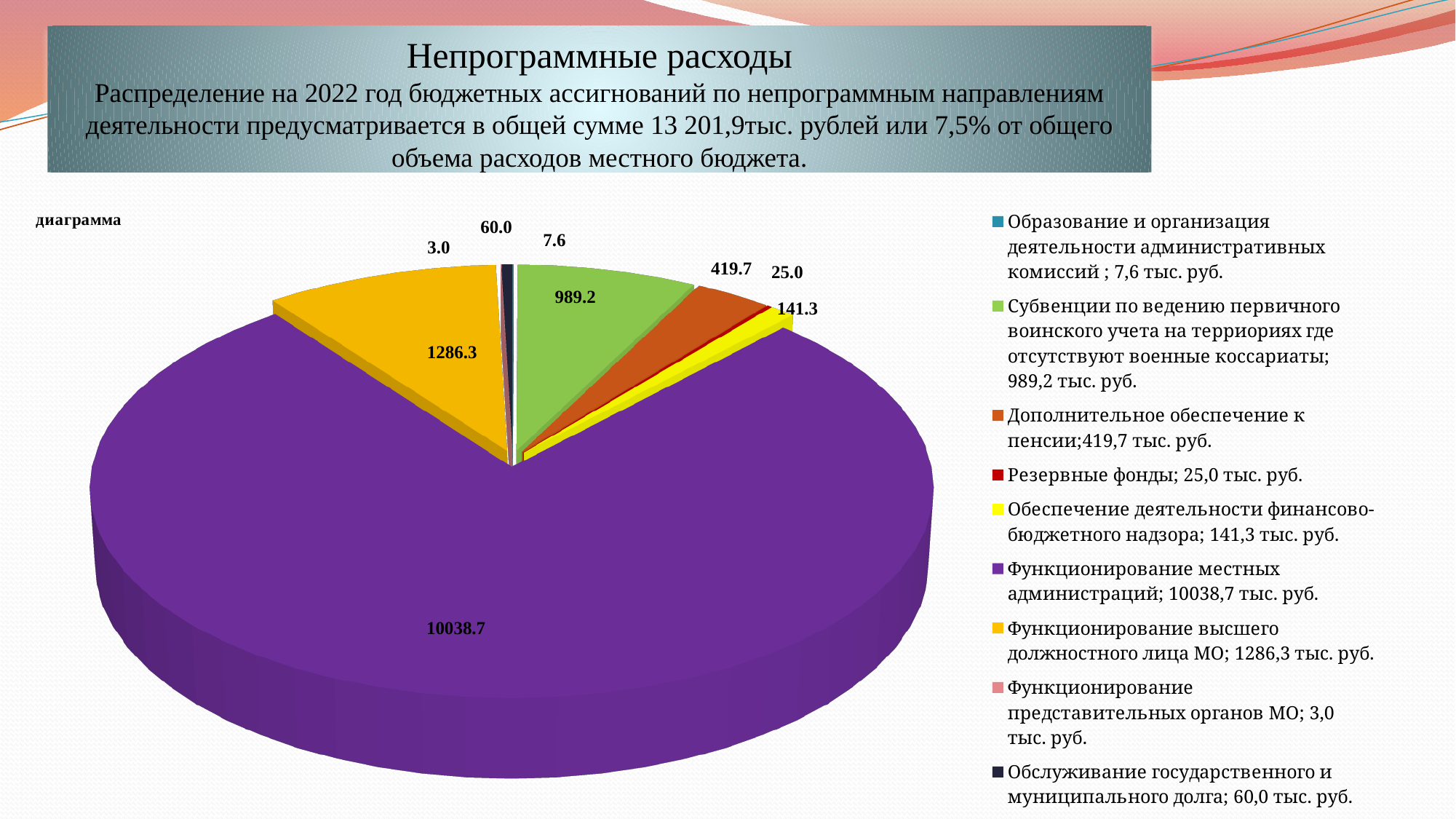
What is the value for Функционирование местных администраций? 10038.7 What is the value for Дополнительное обеспечение к пенсии? 419.7 What is the value for Субвенции по ведению первичного воинского учета? 989.2 What is the value for Обслуживание государственного и муниципального долга? 60.0 Which category has the smallest slice of the pie? Функционирование представительных органов МО What is the difference between the values for Обеспечение деятельности финансово-бюджетного надзора and Обслуживание государственного и муниципального долга? 81.3 Which category has the largest slice of the pie? Функционирование местных администраций What colour is the slice for Функционирование высшего должностного лица МО? Orange Which is larger: the value for Резервные фонды or the value for Обеспечение деятельности финансово-бюджетного надзора? Обеспечение деятельности финансово-бюджетного надзора How many slices does the pie chart have? 9 What type of chart is shown on the slide? Pie chart What is the difference between the values for Функционирование высшего должностного лица МО and Субвенции по ведению первичного воинского учета? 297.1